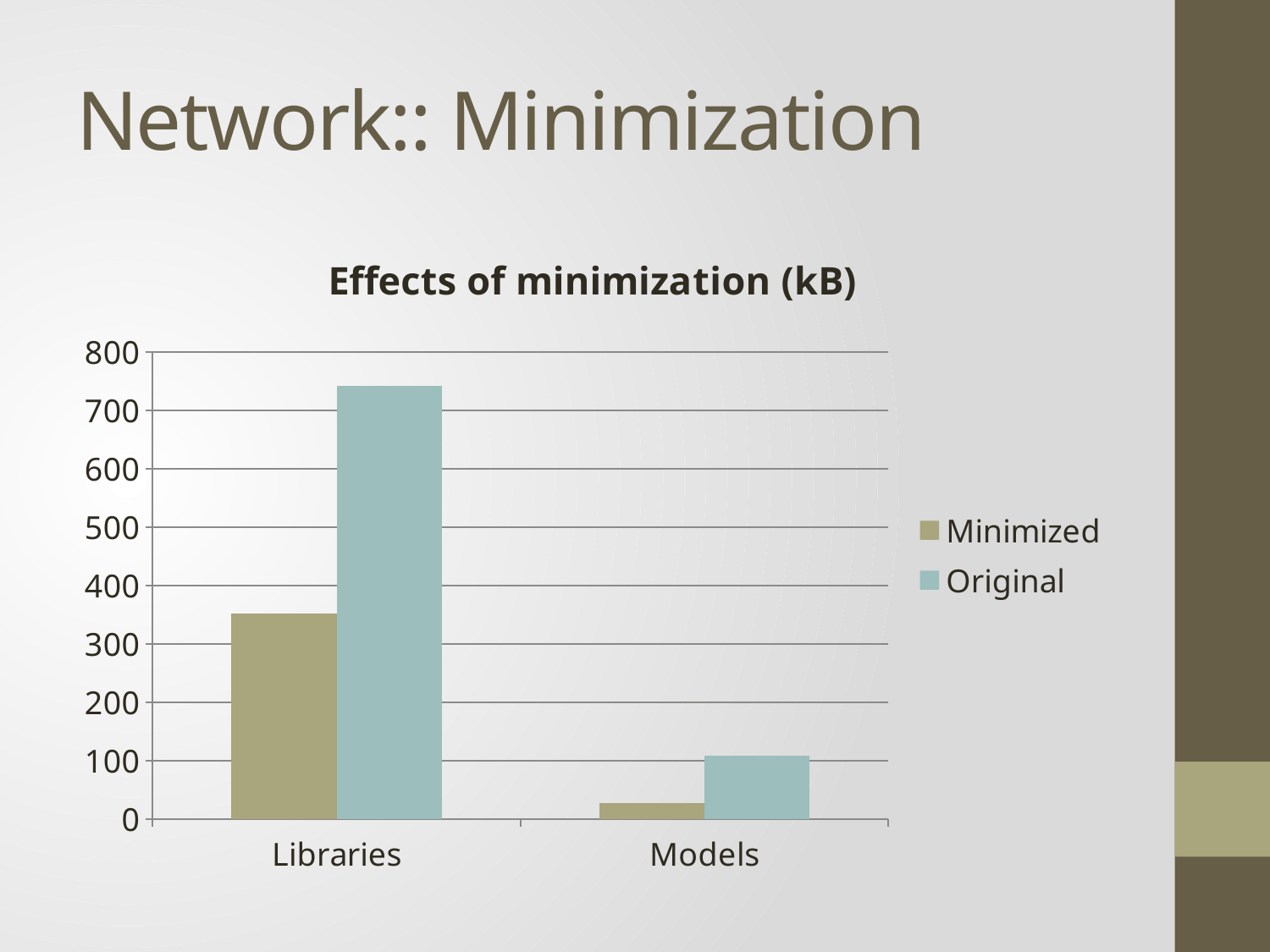
What type of chart is shown on the slide? bar chart How many categories are shown on the x axis? 2 Is the Minimized value for Models greater or less than 100? less Is the Minimized value for Libraries greater or less than 400? less Which category has the highest Original value? Libraries Is the Original value for Models greater or less than 200? less Which category has the lowest Minimized value? Models What is the title of the chart? Effects of minimization (kB) How many series does the legend list? 2 For Libraries, which is larger, the Minimized or the Original value? Original Which series is shown in the blue-green colour in the legend? Original